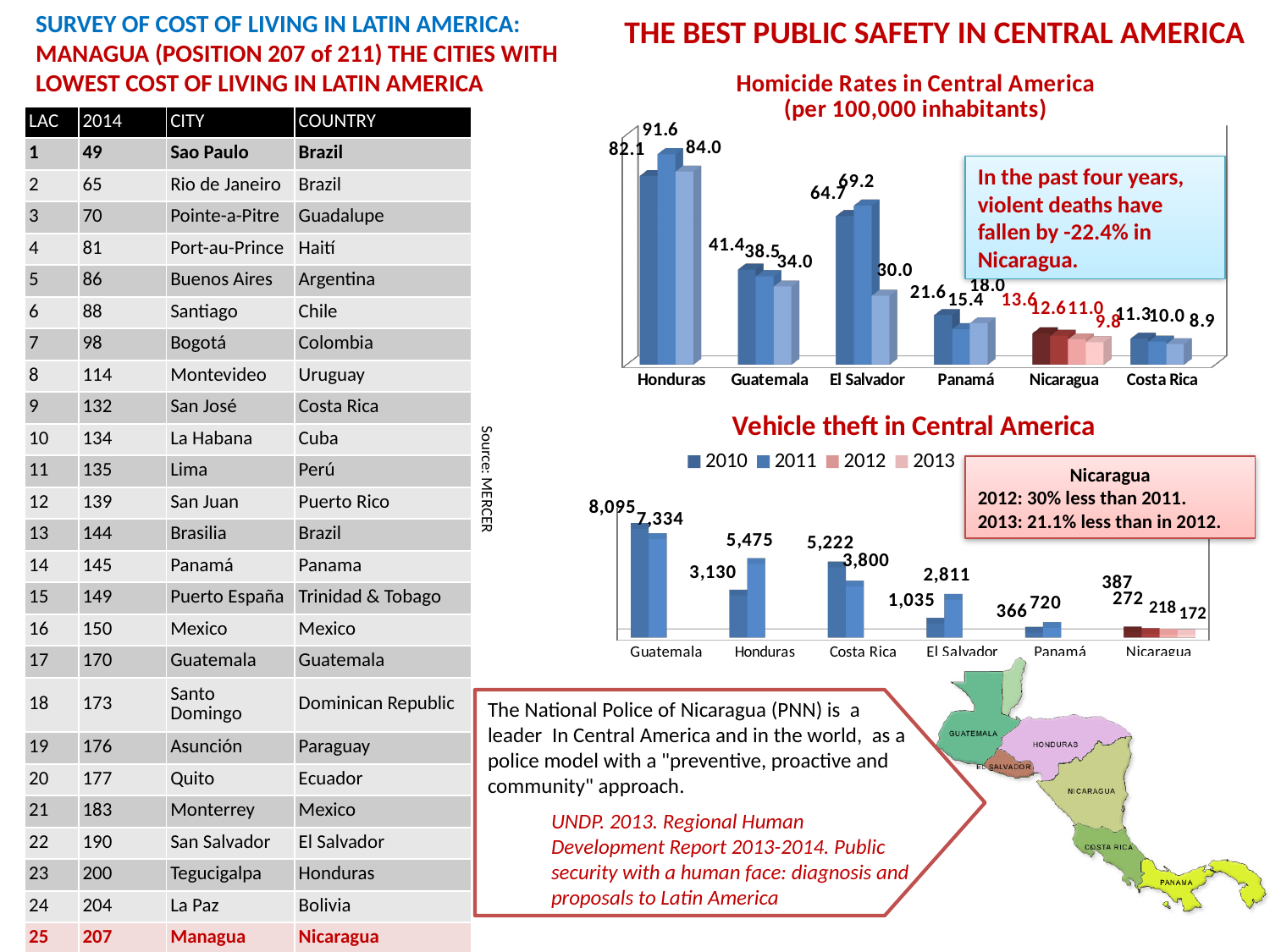
In the 'Homicide Rates in Central America' chart, what is the lowest value labelled for Costa Rica? 8.9 In the 'Homicide Rates in Central America' chart, which country has the tallest bar? Honduras In the 'Homicide Rates in Central America' chart, what is the highest value labelled on any bar? 91.6 In the 'Vehicle theft in Central America' chart, what is the 2010 value for Guatemala? 8,095 How many countries are shown on the x axis of the 'Homicide Rates in Central America' chart? 6 In the 'Vehicle theft in Central America' chart, which is larger: Honduras's 2011 value or Costa Rica's 2010 value? Honduras's 2011 value (5,475) What kind of chart is the 'Homicide Rates in Central America' chart? bar chart How many series does the legend of the 'Vehicle theft in Central America' chart list? 4 In the 'Vehicle theft in Central America' chart, what is the 2013 value for Nicaragua? 172 What are the legend entries of the 'Vehicle theft in Central America' chart? 2010, 2011, 2012, 2013 In the 'Vehicle theft in Central America' chart, which country has the highest value overall? Guatemala In the 'Vehicle theft in Central America' chart, what is the difference between Guatemala's 2010 value (8,095) and its 2011 value (7,334)? 761